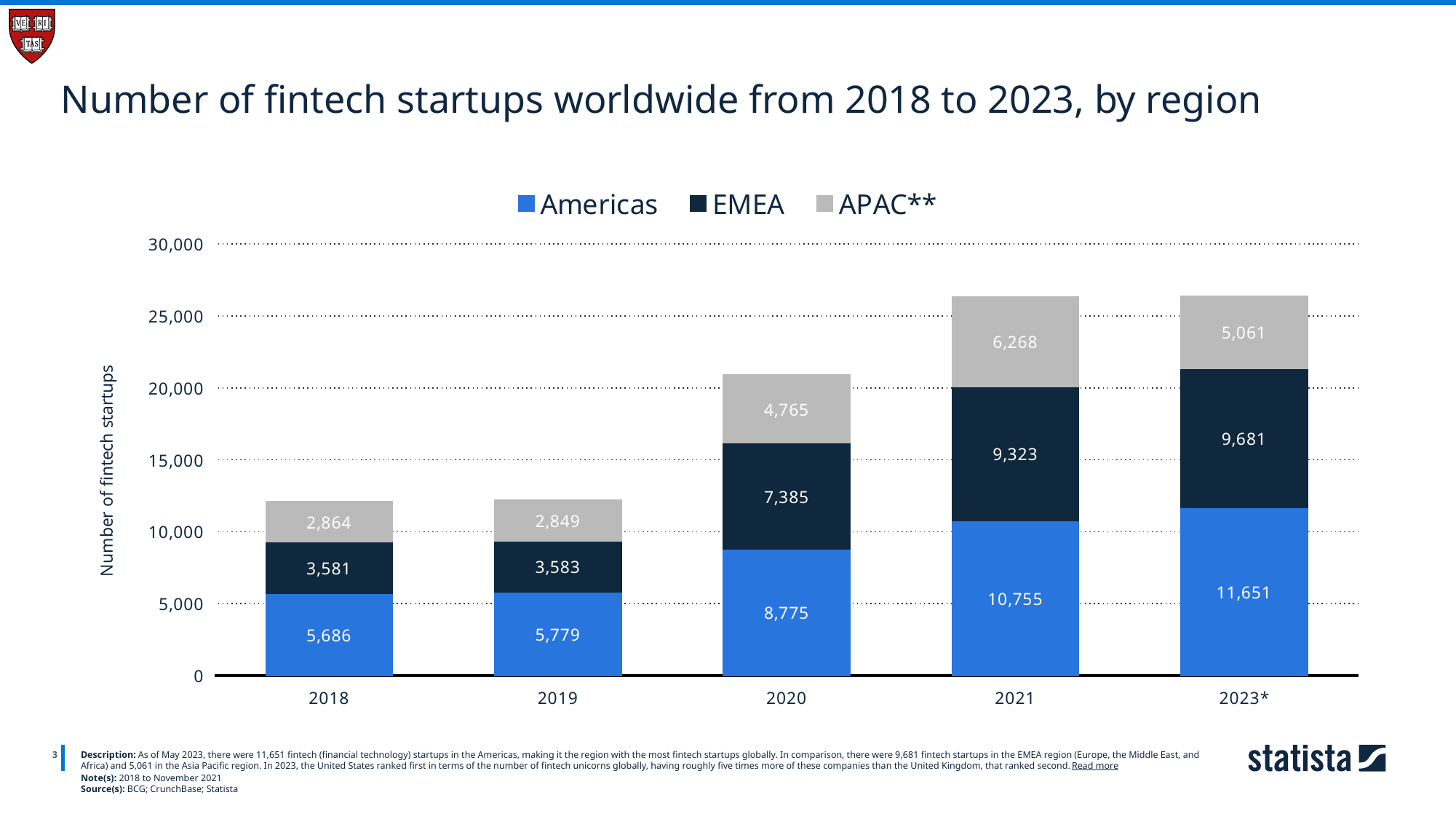
How many series does the legend list? 3 What is the number of fintech startups in APAC** in 2021? 6,268 What is the total number of fintech startups across all three regions in 2020? 20,925 In which year is the Americas value the highest? 2023* What is the difference between the Americas value in 2023* and in 2018? 5,965 What kind of chart is shown on the slide? Stacked bar chart What is the total number of fintech startups across all three regions in 2018? 12,131 Which is larger: the EMEA value in 2021 or the EMEA value in 2020? 2021 What is the number of fintech startups in EMEA in 2020? 7,385 In which year is the APAC** value the lowest? 2019 How many years are shown on the x axis? 5 What is the number of fintech startups in the Americas in 2023*? 11,651